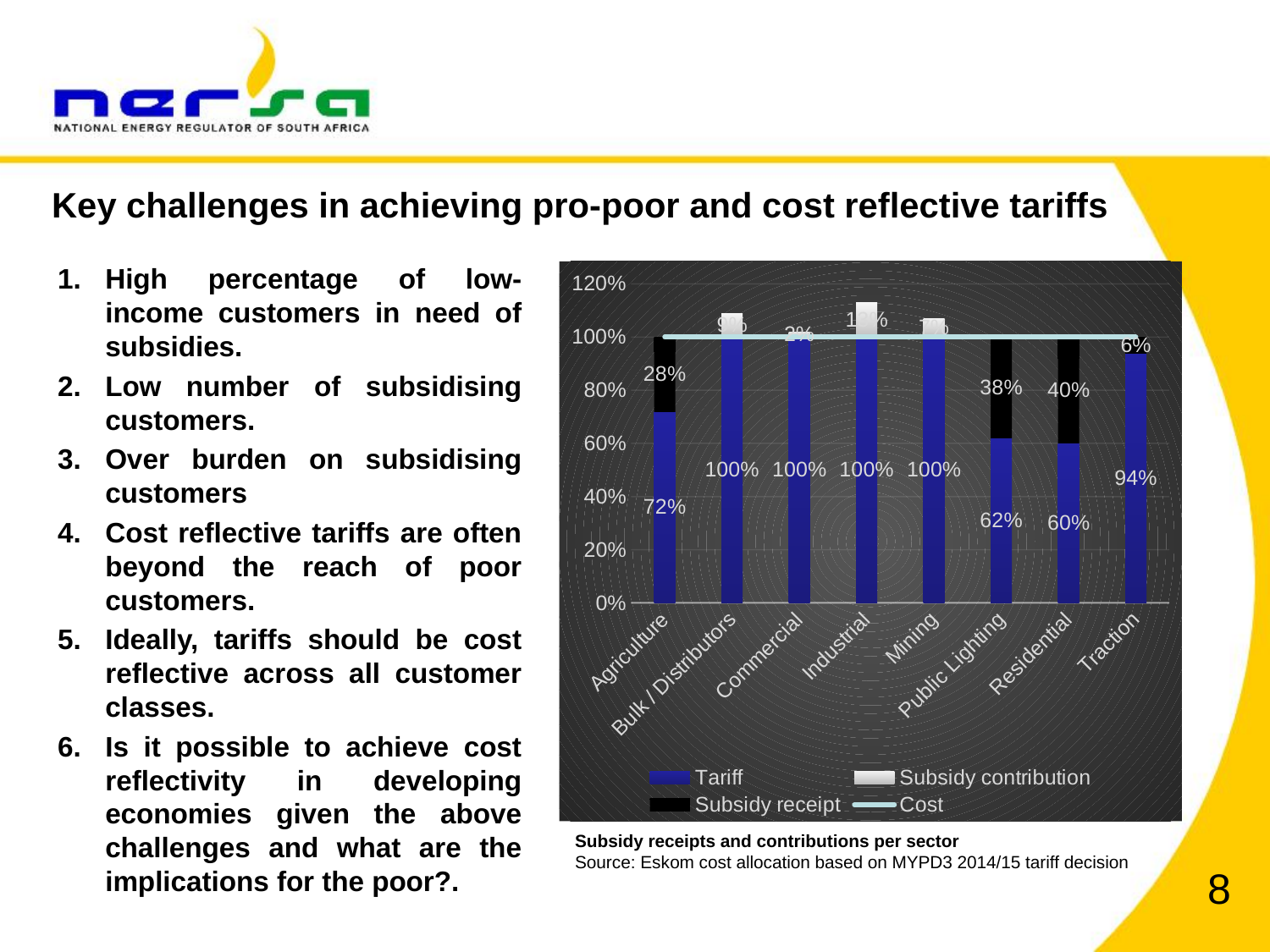
What is the Subsidy receipt value for Residential? 40% What is the difference between the Subsidy receipt values for Residential and Agriculture? 12% Which sector has the highest Subsidy receipt value? Residential Which sector has the lowest Tariff value? Residential What kind of chart is shown on the slide? Stacked bar chart What is the Subsidy receipt value for Public Lighting? 38% How many sectors are shown on the x axis? 8 Which is larger, the Tariff value for Public Lighting or for Residential? Public Lighting How many series does the legend list? 4 What is the Subsidy receipt value for Traction? 6% What is the Tariff value for Traction? 94% What is the Tariff value for Agriculture? 72%